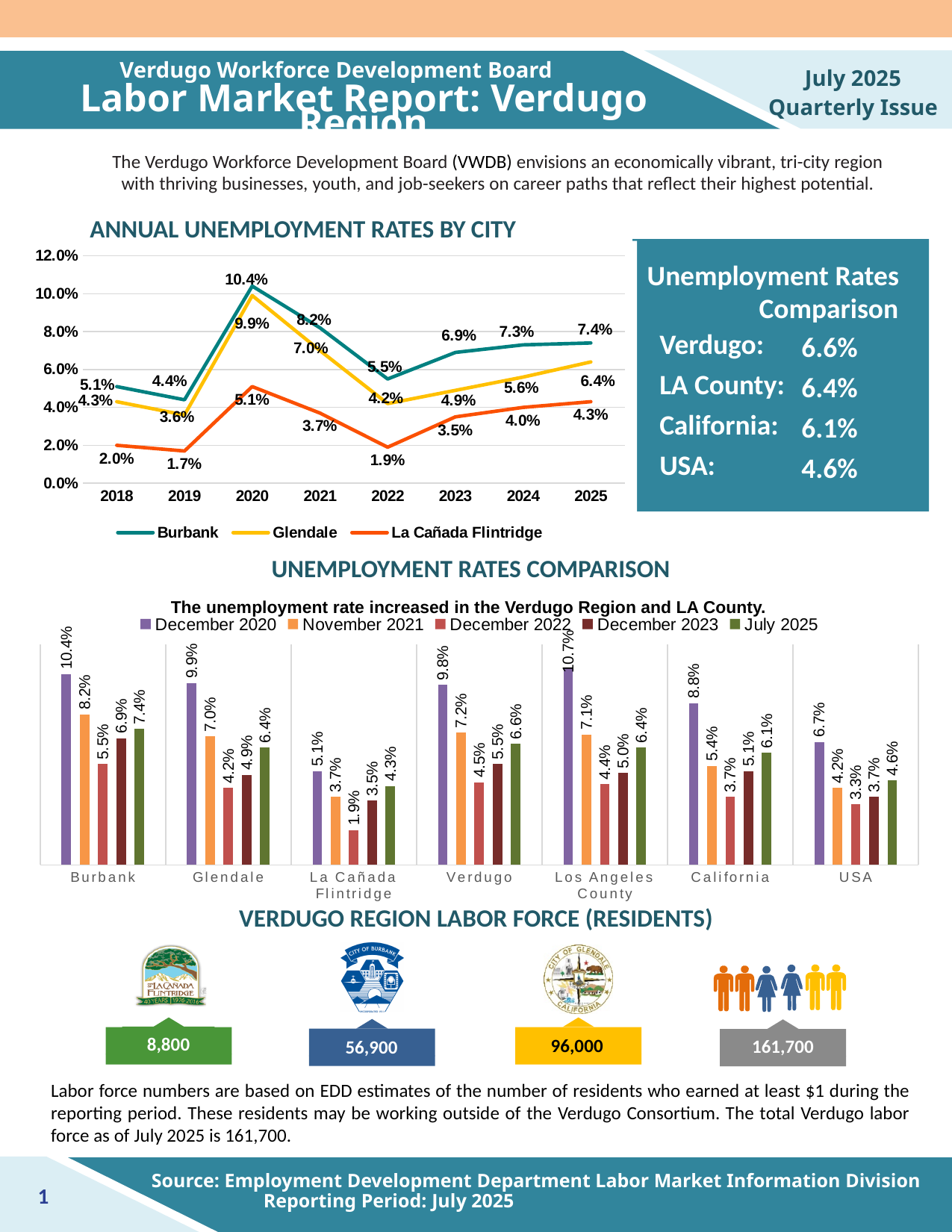
In the Annual Unemployment Rates by City chart, what was La Cañada Flintridge's unemployment rate in 2022? 1.9% In the Annual Unemployment Rates by City chart, how many years are shown on the x axis? 8 In the Annual Unemployment Rates by City chart, which year had the highest unemployment rate for Glendale? 2020 In the Unemployment Rates Comparison chart, which region had the highest December 2020 unemployment rate? Los Angeles County In the Annual Unemployment Rates by City chart, what was Burbank's unemployment rate in 2020? 10.4% In the Unemployment Rates Comparison chart, how many series does the legend list? 5 In the Unemployment Rates Comparison chart, which is larger: the July 2025 rate for Verdugo or for California? Verdugo In the Unemployment Rates Comparison chart, what was the July 2025 unemployment rate for Los Angeles County? 6.4% What kind of chart is the Annual Unemployment Rates by City chart? Line chart In the Annual Unemployment Rates by City chart, how many series does the legend list? 3 In the Annual Unemployment Rates by City chart, what is the difference between Burbank's and Glendale's unemployment rates in 2025? 1.0% In the Annual Unemployment Rates by City chart, which year had the lowest unemployment rate for La Cañada Flintridge? 2019